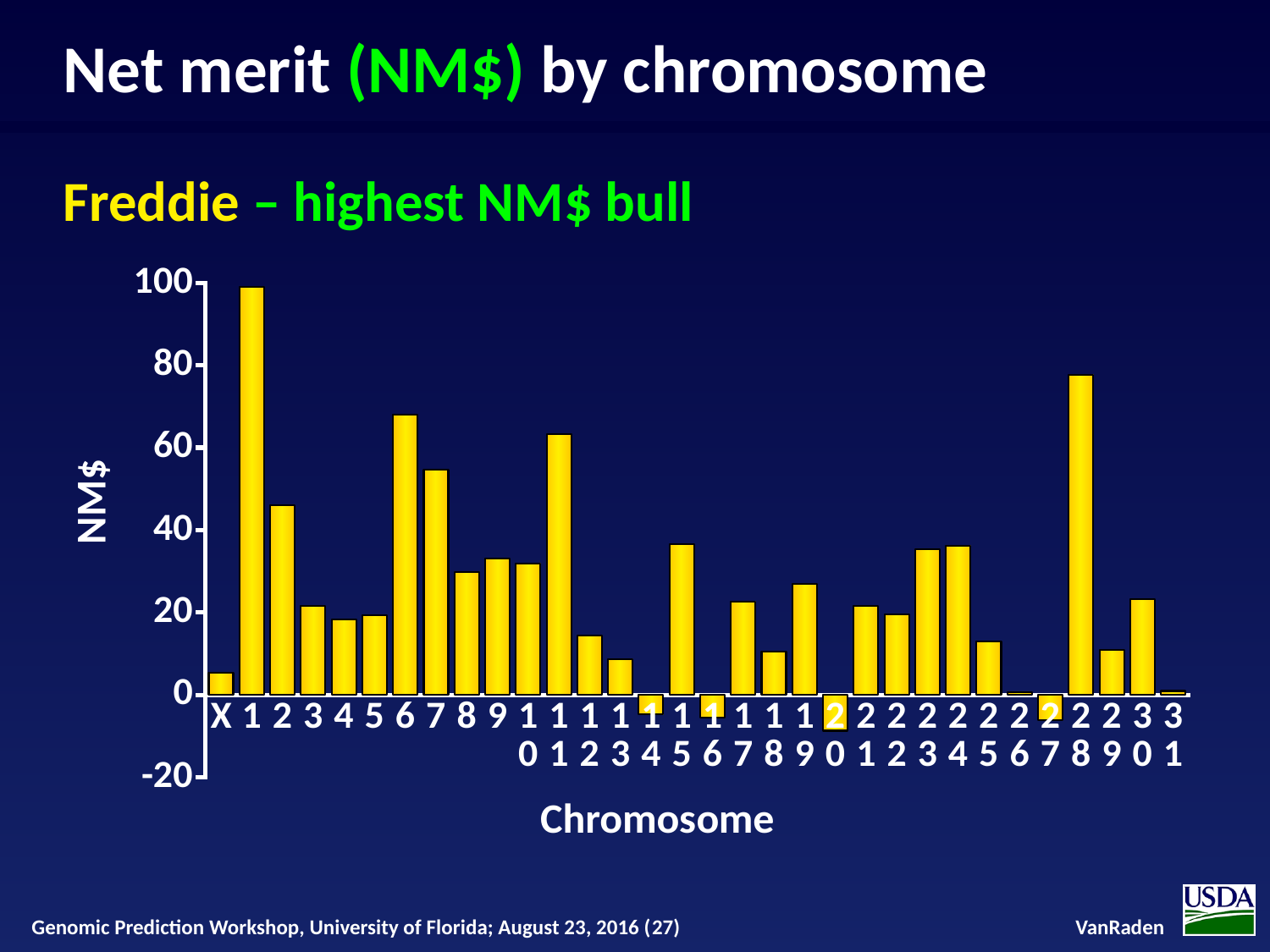
Is the NM$ value for chromosome 28 greater or less than 60? greater Is the NM$ value for chromosome 15 greater or less than 40? less What is the label on the x axis of the chart? Chromosome Which chromosome has the highest NM$ value? 1 Is the NM$ value for chromosome 1 greater or less than 80? greater What is the label on the y axis of the chart? NM$ How many chromosome categories are plotted on the x axis? 32 Which has the larger NM$ value, chromosome 6 or chromosome 7? chromosome 6 What kind of chart is shown on the slide? bar chart Which has the larger NM$ value, chromosome 1 or chromosome 28? chromosome 1